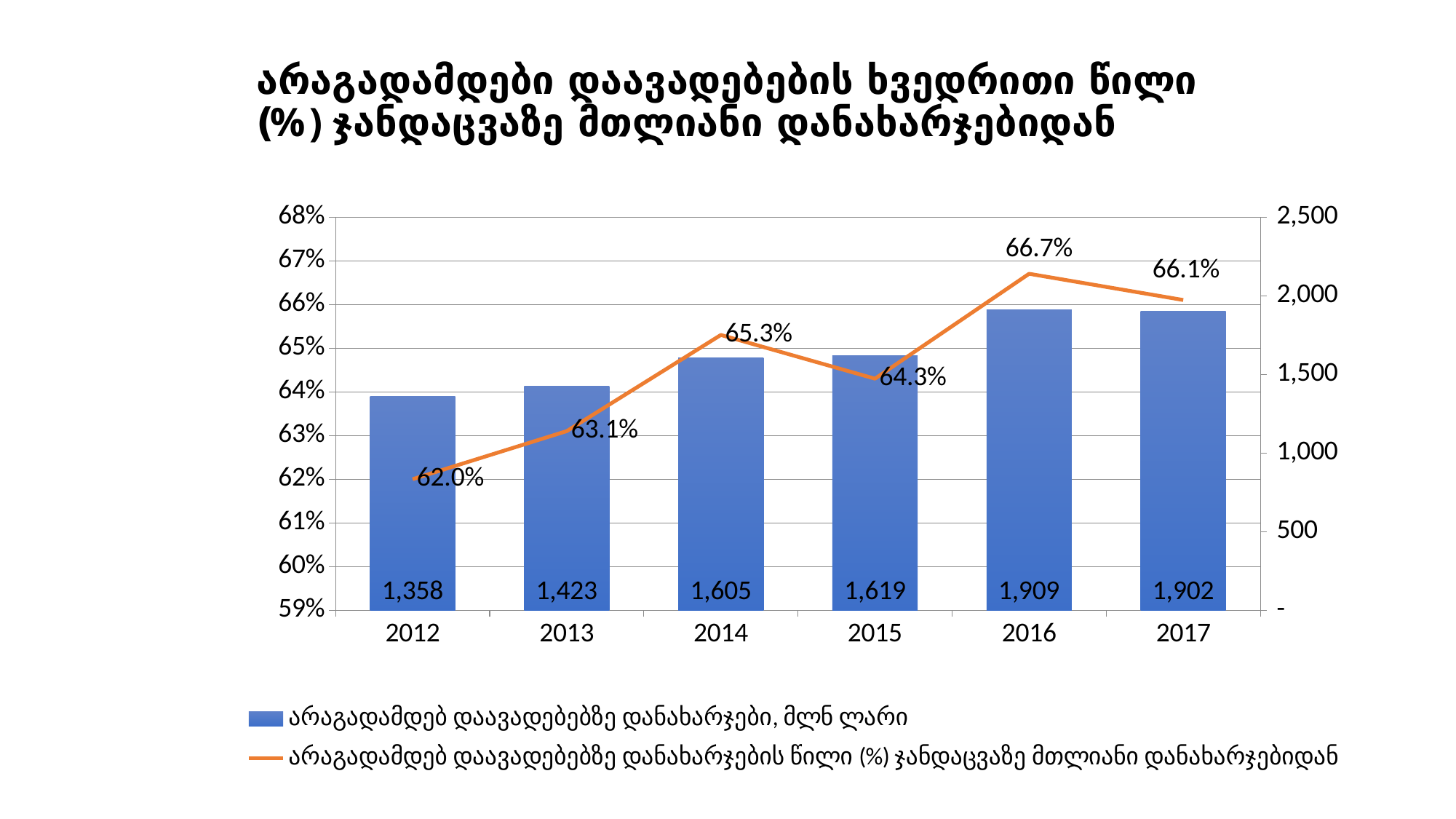
Which year has the highest bar value? 2016 What percentage does the line series show for 2015? 64.3% By how many percentage points does the line value for 2016 exceed the line value for 2015? 2.4 Do the bar values generally rise or fall from 2012 to 2016? Rise Which year has the larger bar value, 2014 or 2015? 2015 What kind of chart is this? Combination bar and line chart How many years are shown on the x axis? 6 How many series does the legend list? 2 Which year has the lowest percentage on the line series? 2012 What is the value of the bar for 2017? 1,902 What is the value of the bar for 2014? 1,605 What is the difference between the bar values for 2017 and 2012? 544